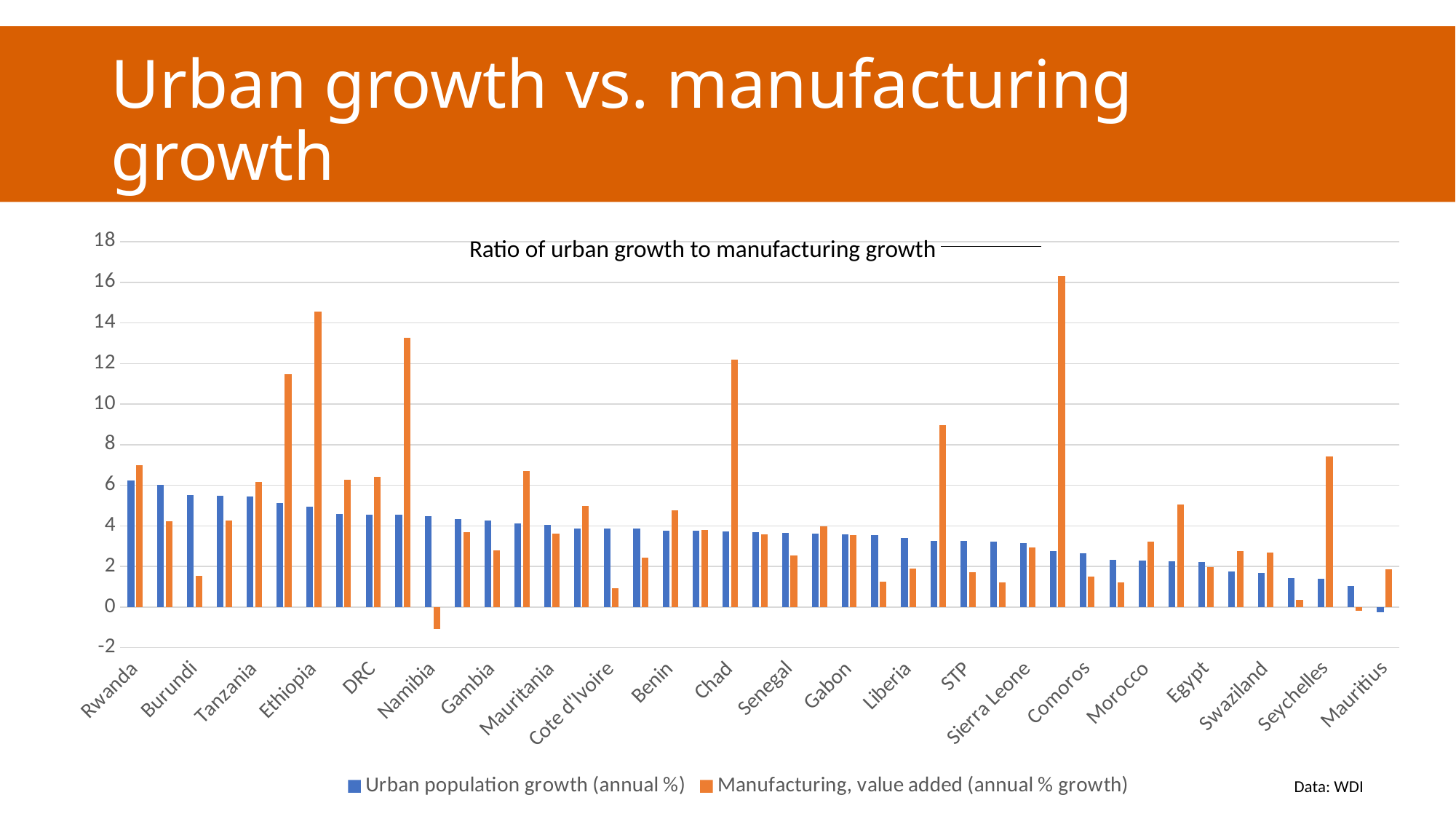
Is the Manufacturing, value added value for Namibia greater or less than 0? less For Burundi, which is larger: Urban population growth or Manufacturing, value added? Urban population growth Is the Manufacturing, value added value for Chad greater or less than 10? greater What kind of chart is shown on the slide? bar chart Do the Urban population growth values rise or fall moving from Rwanda to Mauritius along the x axis? fall How many series does the legend list? 2 Which country has the lowest value for Manufacturing, value added (annual % growth)? Namibia Is the Urban population growth value for Burundi greater or less than 4? greater For Chad, which is larger: Urban population growth or Manufacturing, value added? Manufacturing, value added Which country has the lowest value for Urban population growth (annual %)? Mauritius